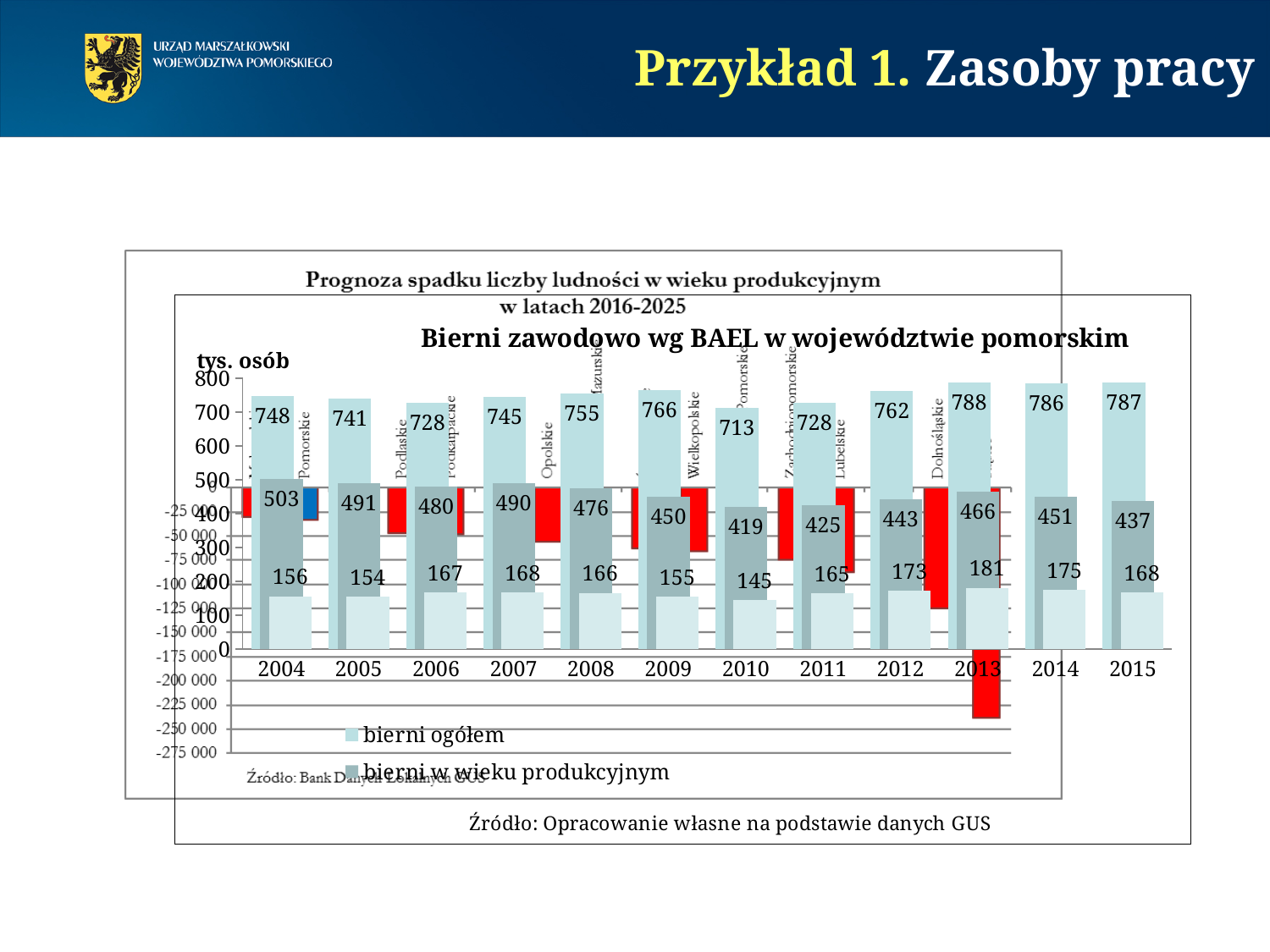
In the chart 'Bierni zawodowo wg BAEL w województwie pomorskim', which year has the highest value of 'bierni w wieku produkcyjnym'? 2004 In the chart 'Bierni zawodowo wg BAEL w województwie pomorskim', what is the value of 'bierni ogółem' for 2004? 748 In the chart 'Bierni zawodowo wg BAEL w województwie pomorskim', what is the difference between 'bierni ogółem' and 'bierni w wieku produkcyjnym' in 2004? 245 In the chart 'Bierni zawodowo wg BAEL w województwie pomorskim', does the value of 'bierni w wieku produkcyjnym' rise or fall from 2004 to 2010? fall In the chart 'Bierni zawodowo wg BAEL w województwie pomorskim', which year has the lowest value of 'bierni ogółem'? 2010 In the chart 'Bierni zawodowo wg BAEL w województwie pomorskim', which year has the highest value of 'bierni ogółem'? 2013 In the chart 'Bierni zawodowo wg BAEL w województwie pomorskim', what is the value of 'bierni ogółem' for 2015? 787 In the chart 'Bierni zawodowo wg BAEL w województwie pomorskim', what is the value of 'bierni w wieku produkcyjnym' for 2010? 419 What is the title of the chart in the background, behind the chart 'Bierni zawodowo wg BAEL w województwie pomorskim'? Prognoza spadku liczby ludności w wieku produkcyjnym w latach 2016-2025 In the chart 'Bierni zawodowo wg BAEL w województwie pomorskim', which year has the larger value of 'bierni ogółem', 2009 or 2010? 2009 In the chart 'Bierni zawodowo wg BAEL w województwie pomorskim', how many years are shown on the x axis? 12 What kind of chart is 'Bierni zawodowo wg BAEL w województwie pomorskim'? bar chart